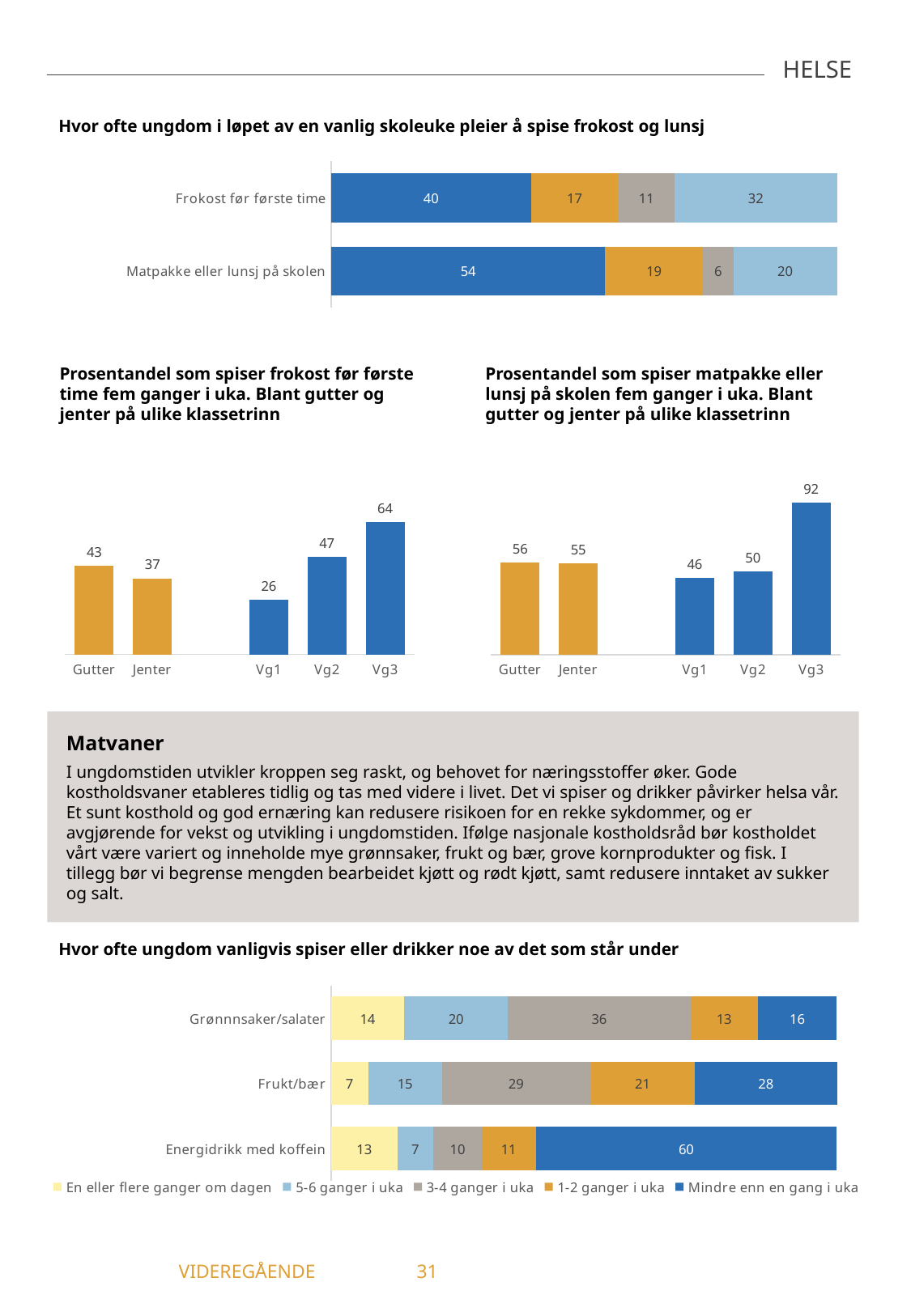
In the chart 'Prosentandel som spiser frokost før første time fem ganger i uka', what is the value for Vg3? 64 In the chart 'Prosentandel som spiser frokost før første time fem ganger i uka', what is the difference between Gutter and Jenter? 6 What kind of chart is 'Hvor ofte ungdom i løpet av en vanlig skoleuke pleier å spise frokost og lunsj'? stacked bar chart In the chart 'Hvor ofte ungdom i løpet av en vanlig skoleuke pleier å spise frokost og lunsj', what is the total of the stacked bar for 'Matpakke eller lunsj på skolen'? 99 In the chart 'Hvor ofte ungdom vanligvis spiser eller drikker noe av det som står under', how many series does the legend list? 5 In the chart 'Hvor ofte ungdom vanligvis spiser eller drikker noe av det som står under', what is the value for 'Mindre enn en gang i uka' for Energidrikk med koffein? 60 In the chart 'Prosentandel som spiser matpakke eller lunsj på skolen fem ganger i uka', do the values rise or fall from Vg1 to Vg3? rise In the chart 'Hvor ofte ungdom vanligvis spiser eller drikker noe av det som står under', what is the value for '3-4 ganger i uka' for Frukt/bær? 29 In the chart 'Prosentandel som spiser matpakke eller lunsj på skolen fem ganger i uka', which category has the highest value? Vg3 In the chart 'Prosentandel som spiser frokost før første time fem ganger i uka', which category has the lowest value? Vg1 In the chart 'Prosentandel som spiser matpakke eller lunsj på skolen fem ganger i uka', what is the value for Vg3? 92 In the chart 'Prosentandel som spiser matpakke eller lunsj på skolen fem ganger i uka', how many categories are shown on the x axis? 5